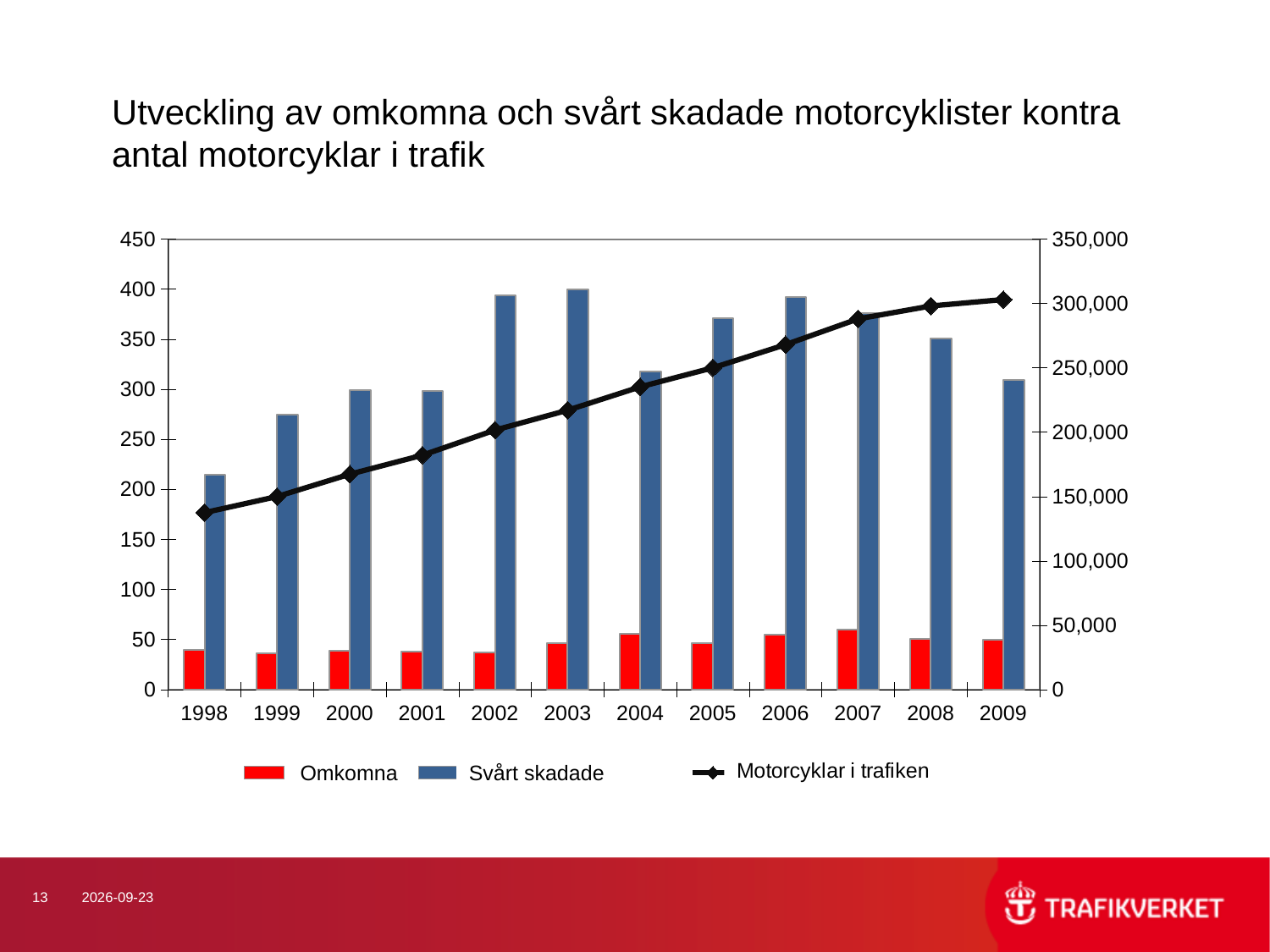
Is the value for Omkomna in 1999 greater or less than 50? less How many series does the chart's legend list? 3 Is the value for Motorcyklar i trafiken in 2009 greater or less than 250,000? greater Is the value for Motorcyklar i trafiken in 1998 greater or less than 150,000? less Which is larger, the Svårt skadade value for 2002 or for 2004? 2002 What kind of chart is shown on the slide? A bar chart combined with a line chart Does the Motorcyklar i trafiken line rise or fall from 1998 to 2009? It rises How many years are shown on the x axis of the chart? 12 Which series is drawn as a black line with diamond markers? Motorcyklar i trafiken Which year has the lowest value for Svårt skadade? 1998